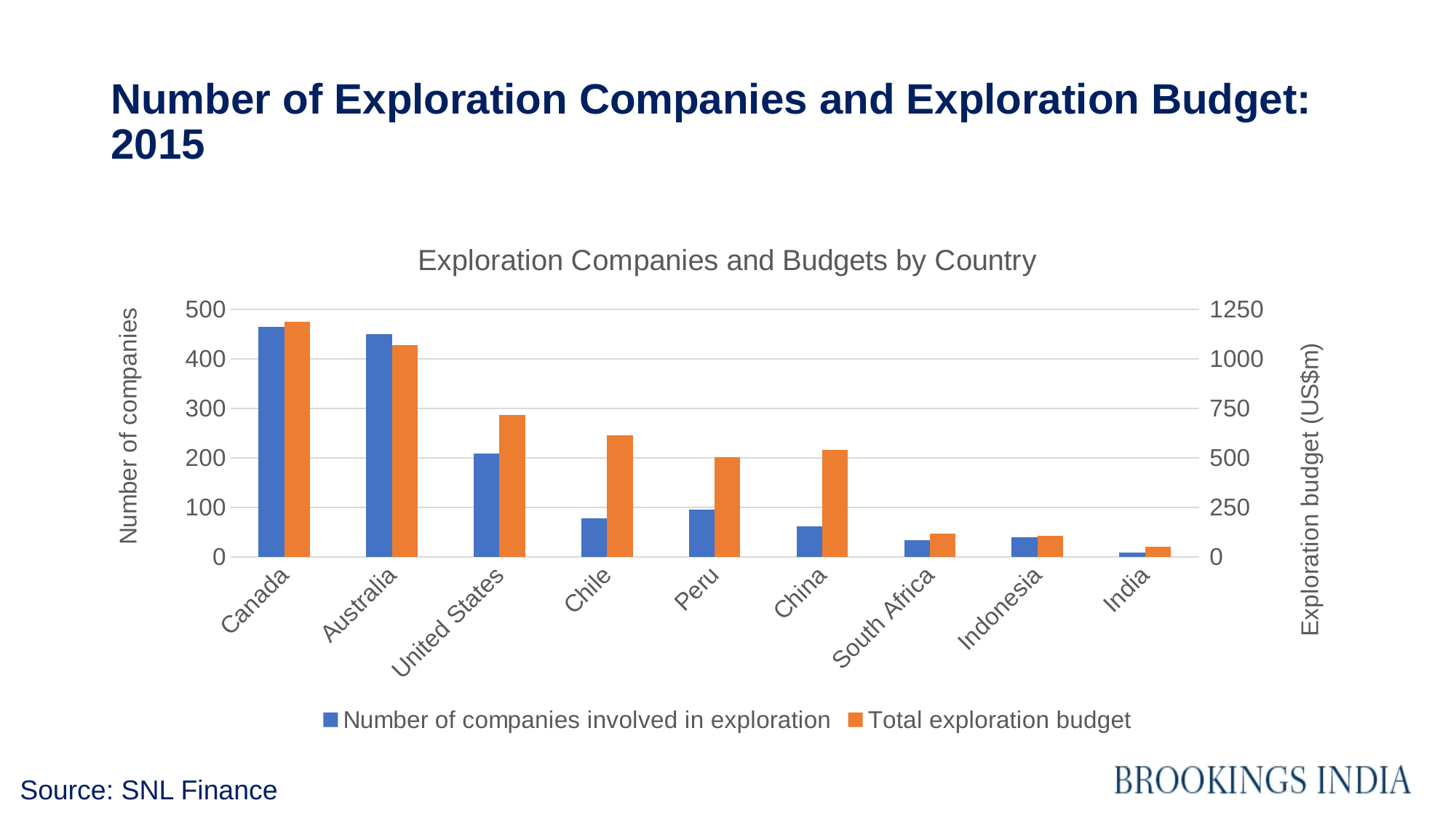
What is the title of the chart? Exploration Companies and Budgets by Country Which has the larger total exploration budget, Chile or Peru? Chile How many countries are shown on the x axis of the chart? 9 Which country has the lowest number of companies involved in exploration? India Is the number of companies involved in exploration for Canada greater or less than 400? greater What kind of chart is shown on the slide? Bar chart Is the number of companies involved in exploration for Chile greater or less than 100? less Which country has the lowest total exploration budget? India Do the number of companies involved in exploration generally rise or fall from Canada to India along the x axis? fall Is the total exploration budget for the United States greater or less than 500? greater Which country has the highest total exploration budget? Canada How many series does the chart's legend list? 2